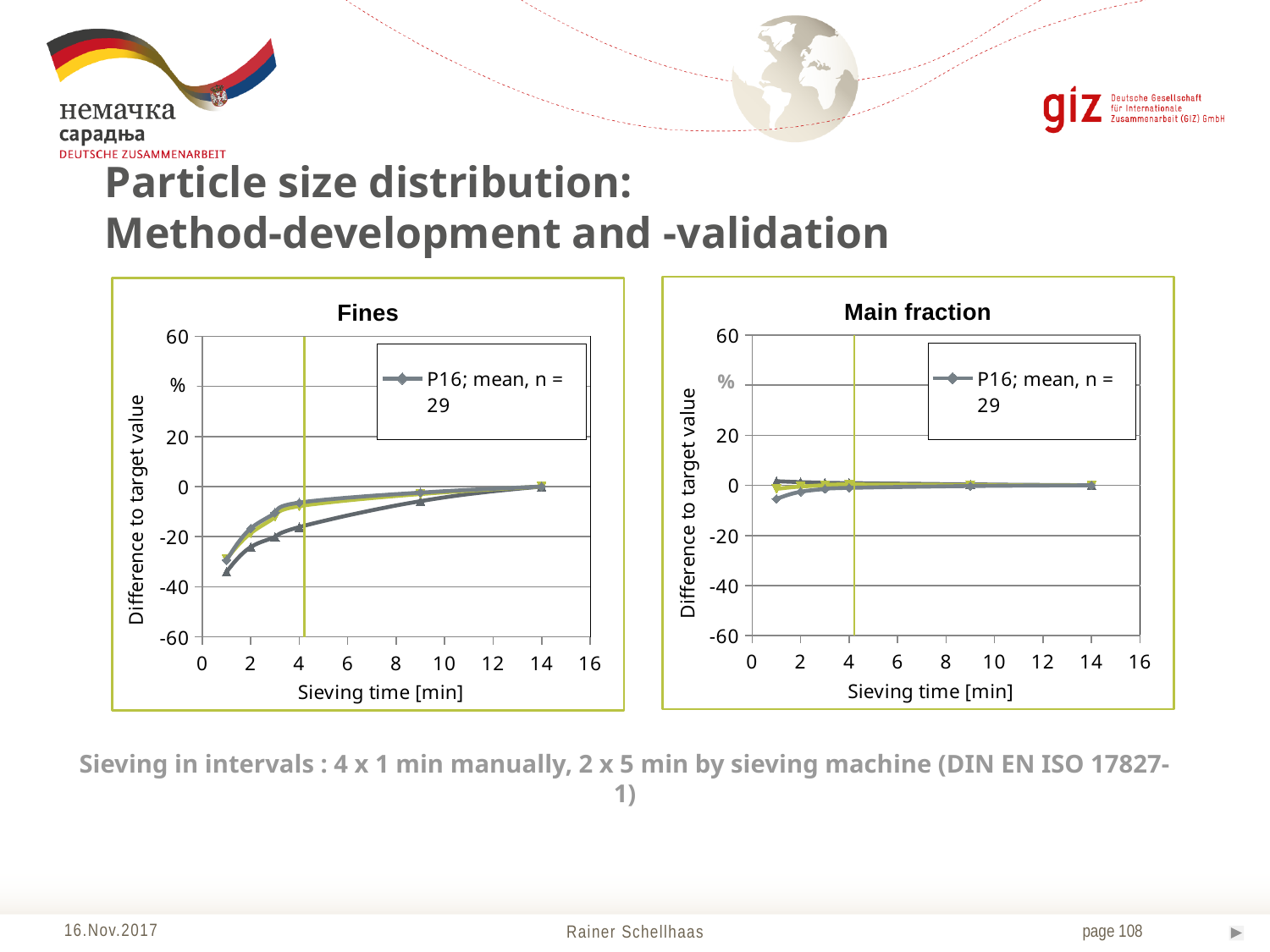
In the "Main fraction" chart, is the value at a sieving time of 9 min greater or less than -20? greater In the "Fines" chart, do the values rise or fall as sieving time increases? rise In the "Fines" chart, is the value at a sieving time of 14 min greater or less than -20? greater In the "Main fraction" chart, is the value at a sieving time of 14 min greater or less than 20? less What is the legend entry shown in the "Main fraction" chart? P16; mean, n = 29 What kind of chart is the "Main fraction" chart? line chart What is the x-axis title of the "Fines" chart? Sieving time [min] What kind of chart is the "Fines" chart? line chart How many series does the legend of the "Fines" chart list? 1 How many series does the legend of the "Main fraction" chart list? 1